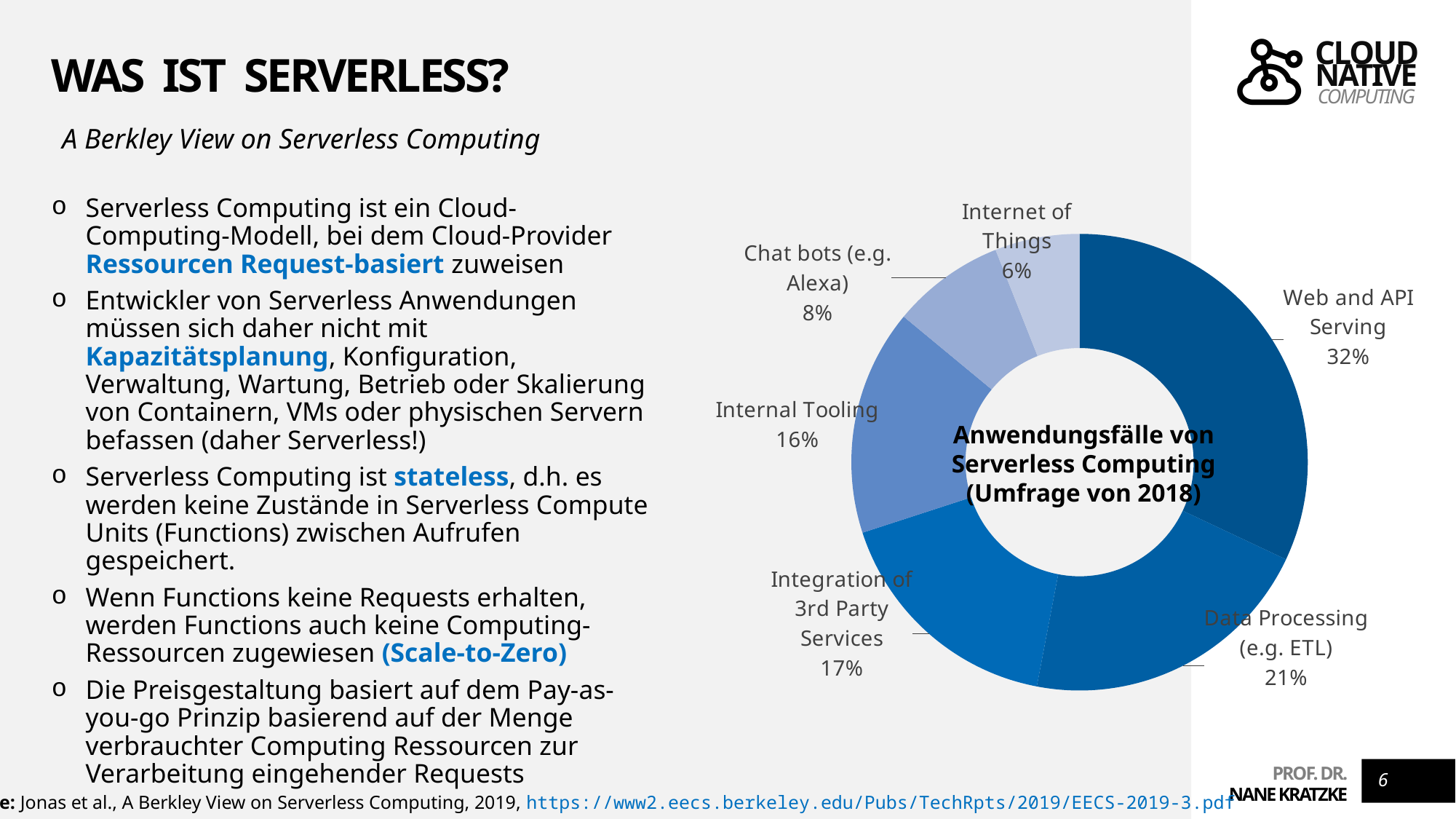
What is the combined share of Chat bots (e.g. Alexa) and Internet of Things? 14% What is the difference in percentage points between Web and API Serving and Data Processing (e.g. ETL)? 11 What share does Web and API Serving have in the chart? 32% What is the value for Internal Tooling? 16% Which category has the largest share in the chart? Web and API Serving Which is larger: Integration of 3rd Party Services or Internal Tooling? Integration of 3rd Party Services What percentage is shown for Chat bots (e.g. Alexa)? 8% How many categories are shown in the chart? 6 What kind of chart is shown on the slide? Doughnut (pie) chart What is the title shown in the centre of the chart? Anwendungsfälle von Serverless Computing (Umfrage von 2018) What percentage is shown for Data Processing (e.g. ETL)? 21% Which category has the smallest share in the chart? Internet of Things